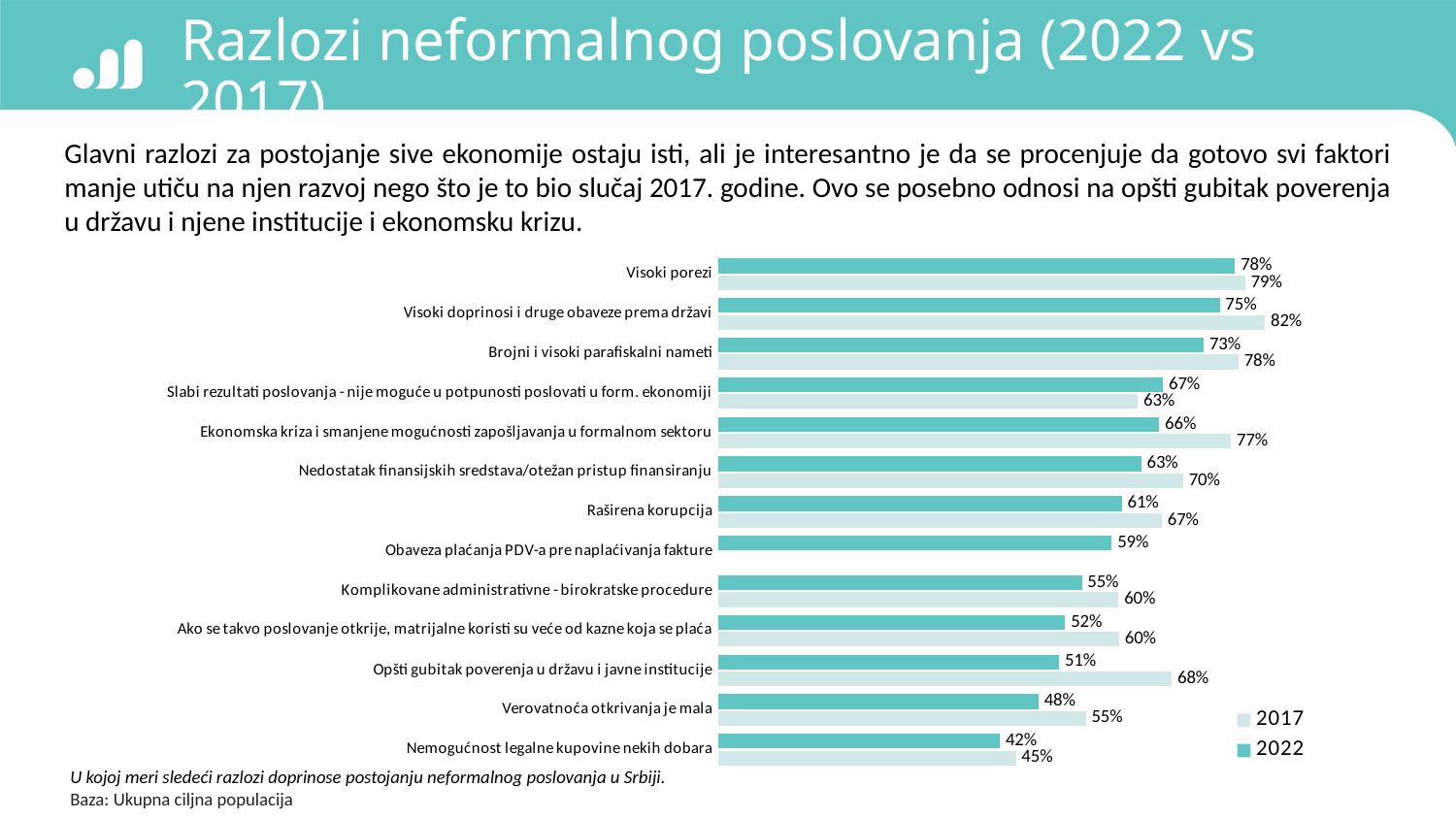
What is the difference between the 2017 and 2022 values for "Ekonomska kriza i smanjene mogućnosti zapošljavanja u formalnom sektoru"? 11% Which is larger for "Slabi rezultati poslovanja - nije moguće u potpunosti poslovati u form. ekonomiji": the 2017 value or the 2022 value? 2022 How many series does the legend list? 2 What is the 2017 value for "Visoki doprinosi i druge obaveze prema državi"? 82% What is the 2022 value for "Visoki porezi"? 78% Which category has the lowest 2017 value? Nemogućnost legalne kupovine nekih dobara What is the 2022 value for "Opšti gubitak poverenja u državu i javne institucije"? 51% What is the difference between the 2017 and 2022 values for "Opšti gubitak poverenja u državu i javne institucije"? 17% What kind of chart is shown on the slide? bar chart Which category has the highest 2022 value? Visoki porezi Which category has only a 2022 value and no 2017 value shown? Obaveza plaćanja PDV-a pre naplaćivanja fakture How many categories are shown on the chart? 13